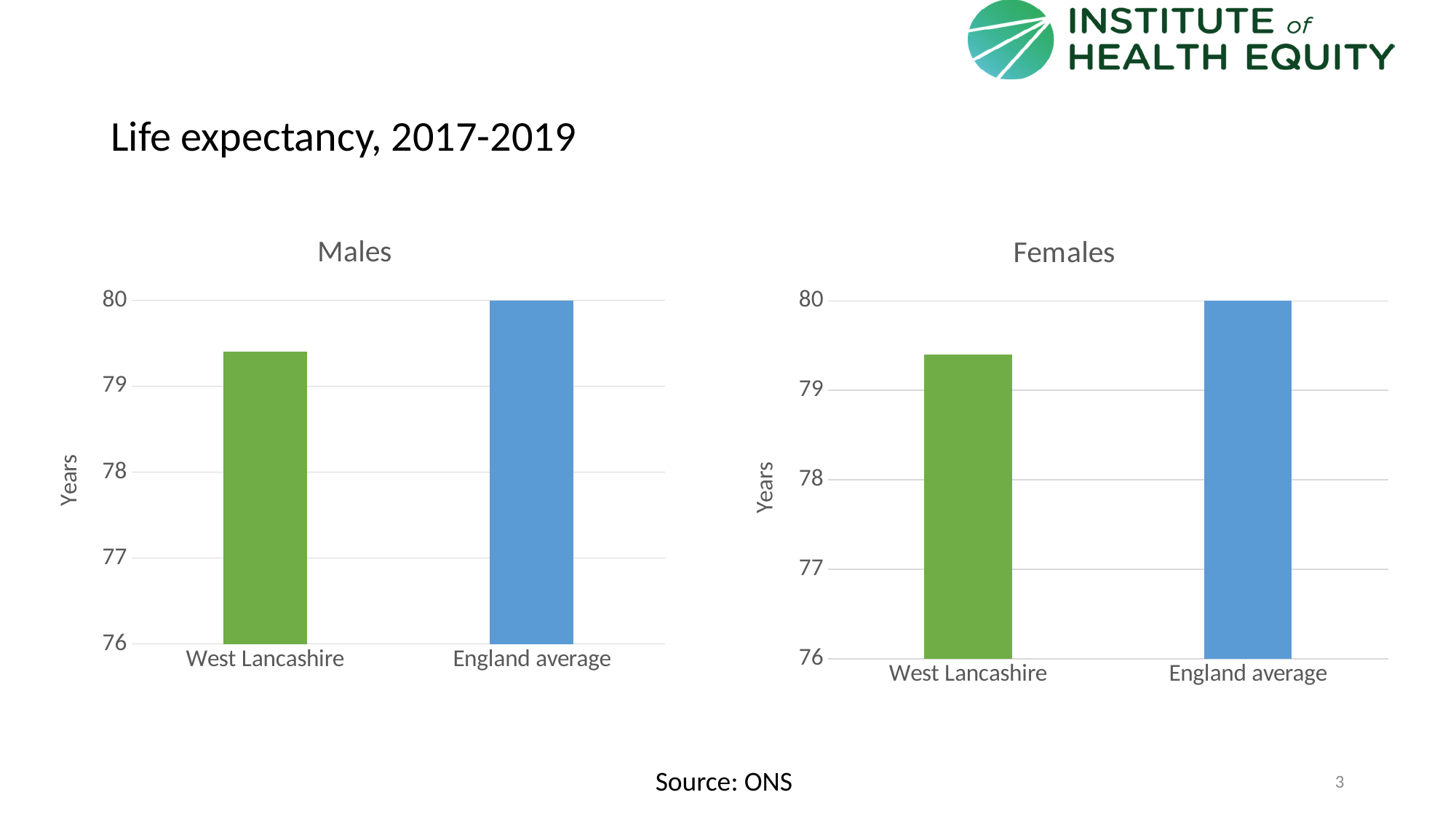
What is the title of the chart on the right of the slide? Females In the Females chart, which category has the lowest life expectancy? West Lancashire In the Males chart, is the value for West Lancashire greater or less than 79? greater In the Females chart, is the value for West Lancashire greater or less than 78? greater What kind of chart is the Males chart? bar chart In the Males chart, which is larger, West Lancashire or England average? England average What is the y-axis label on the Males chart? Years How many categories are shown in the Females chart? 2 In the Males chart, what is the life expectancy for England average? 80 In the Females chart, is the value for West Lancashire greater or less than 80? less In the Females chart, what is the life expectancy for England average? 80 In the Males chart, which category has the highest life expectancy? England average